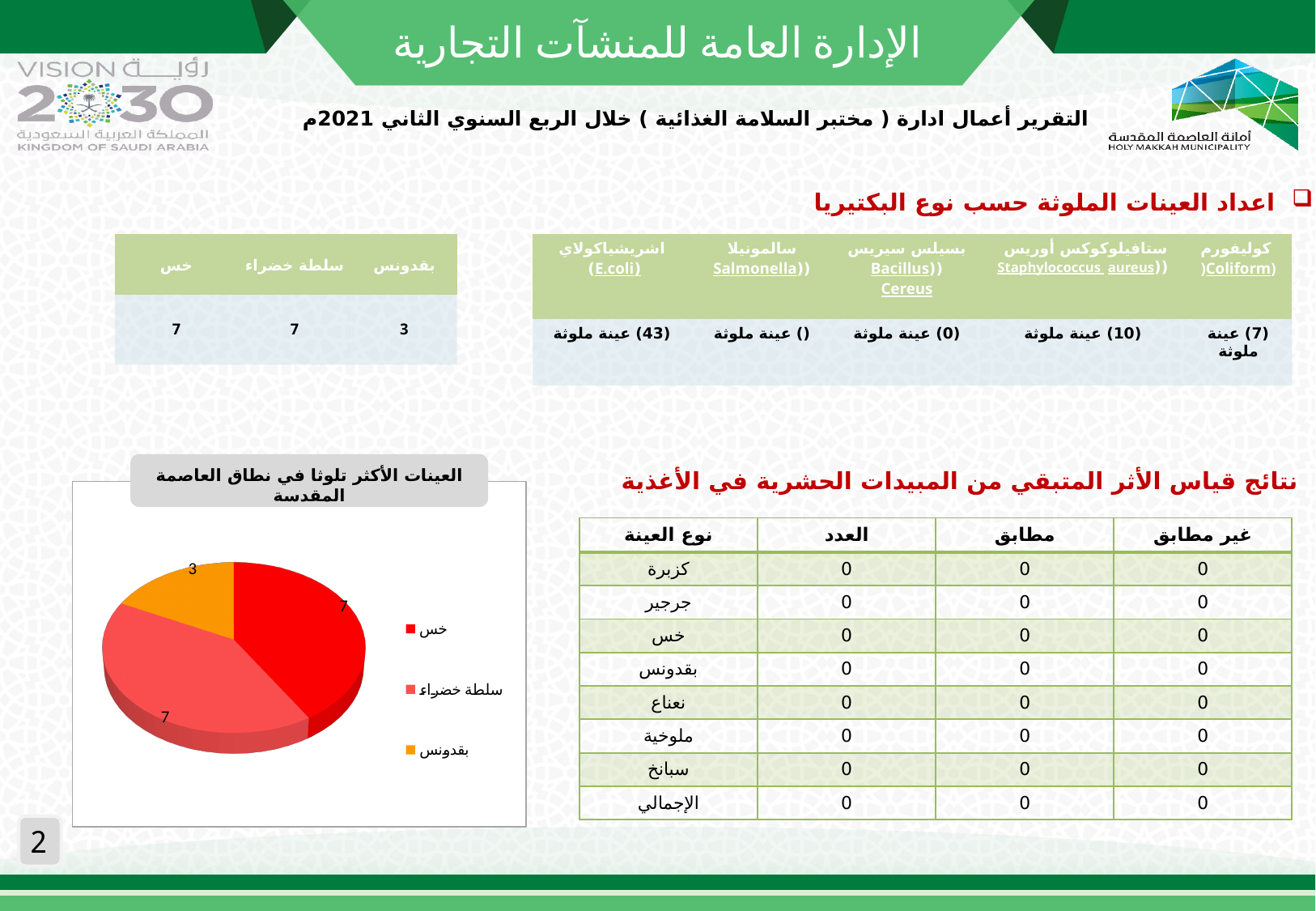
What colour is the بقدونس slice in the pie chart? orange What is the difference between the values for سلطة خضراء and بقدونس in the pie chart? 4 What is the value for سلطة خضراء in the pie chart? 7 What kind of chart is shown on the slide? pie chart Which is larger in the pie chart, خس or بقدونس? خس How many slices does the pie chart have? 3 What is the title of the pie chart? العينات الأكثر تلوثا في نطاق العاصمة المقدسة What is the value for بقدونس in the pie chart? 3 What is the total of all slices in the pie chart? 17 Which category has the smallest slice in the pie chart? بقدونس How many entries does the legend of the pie chart list? 3 What is the value for خس in the pie chart? 7